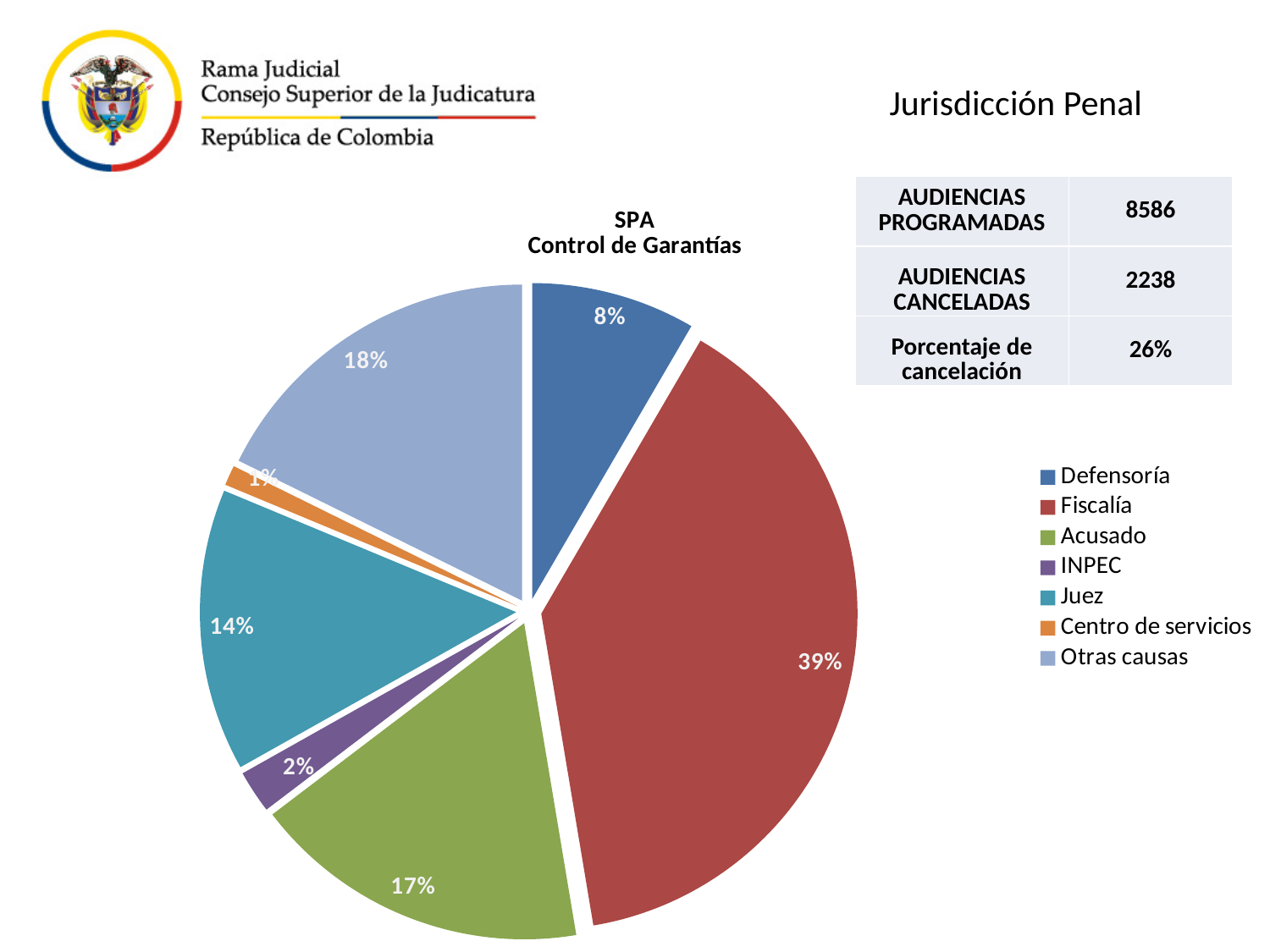
What is the value shown for Acusado? 17% What is the title of the pie chart? SPA Control de Garantías What type of chart is shown on the slide? Pie chart What is the value shown for INPEC? 2% What share of the pie does Fiscalía represent? 39% What is the difference between the shares of Fiscalía and Acusado? 22% Which is larger, the share for Otras causas or the share for Juez? Otras causas How many categories does the legend list? 7 Which category has the largest slice of the pie? Fiscalía What is the value shown for Juez? 14% Which category has the smallest slice of the pie? Centro de servicios What share of the pie does Otras causas represent? 18%